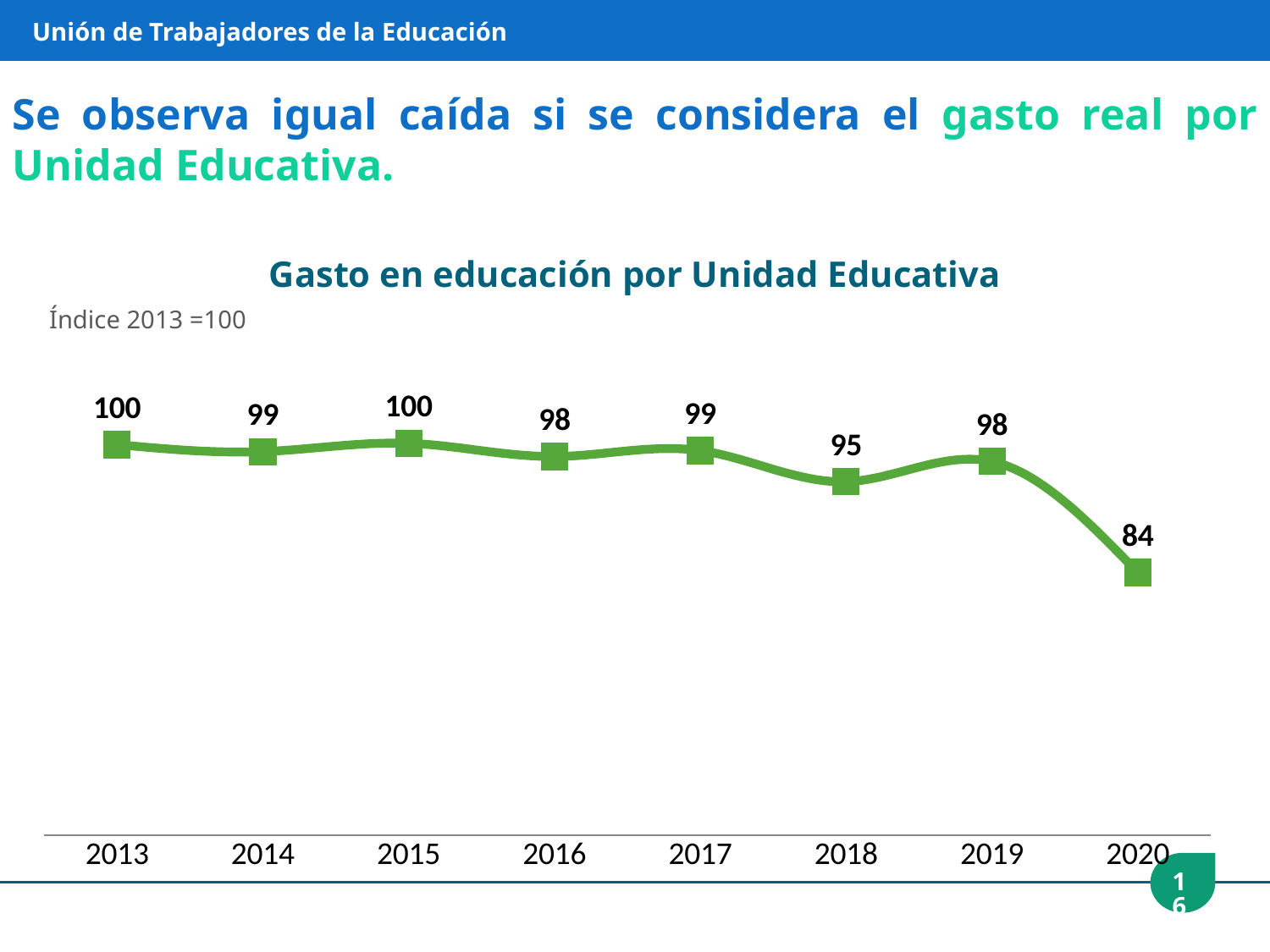
What is the title of the chart? Gasto en educación por Unidad Educativa How many years are plotted on the chart? 8 What is the value for 2018? 95 Do the values generally rise or fall from 2013 to 2020? fall Which is larger, the value for 2017 or the value for 2018? 2017 What is the value for 2016? 98 Which year has the lowest value? 2020 What base index is stated below the chart title? Índice 2013 =100 What is the value for 2020? 84 What is the difference between the values for 2019 and 2020? 14 What kind of chart is shown? line chart What is the difference between the values for 2013 and 2018? 5